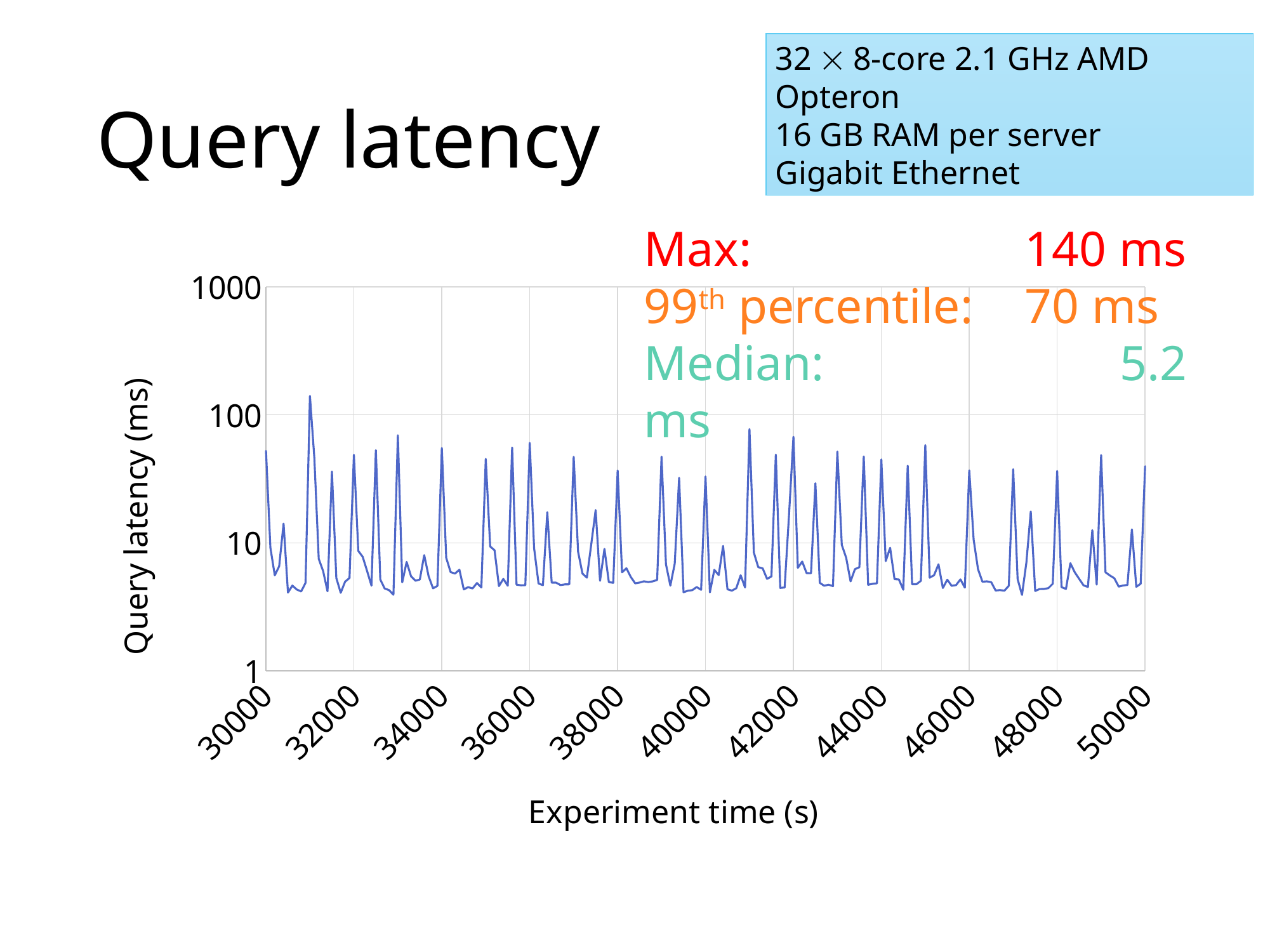
How many labelled tick marks are on the x axis? 11 What kind of chart is shown on the slide? line chart What is the maximum query latency stated on the slide? 140 ms Is the highest spike in the line greater or less than 100 ms? greater Are the lowest points of the line greater or less than 10 ms? less What is the label of the y axis? Query latency (ms) Is the value at the start of the line, at 30000 s, greater or less than 10 ms? greater What is the label of the x axis? Experiment time (s) What is the 99th percentile query latency stated on the slide? 70 ms Which is larger, the 99th percentile latency or the median latency? 99th percentile What is the difference between the maximum and the 99th percentile query latency? 70 ms What is the median query latency stated on the slide? 5.2 ms